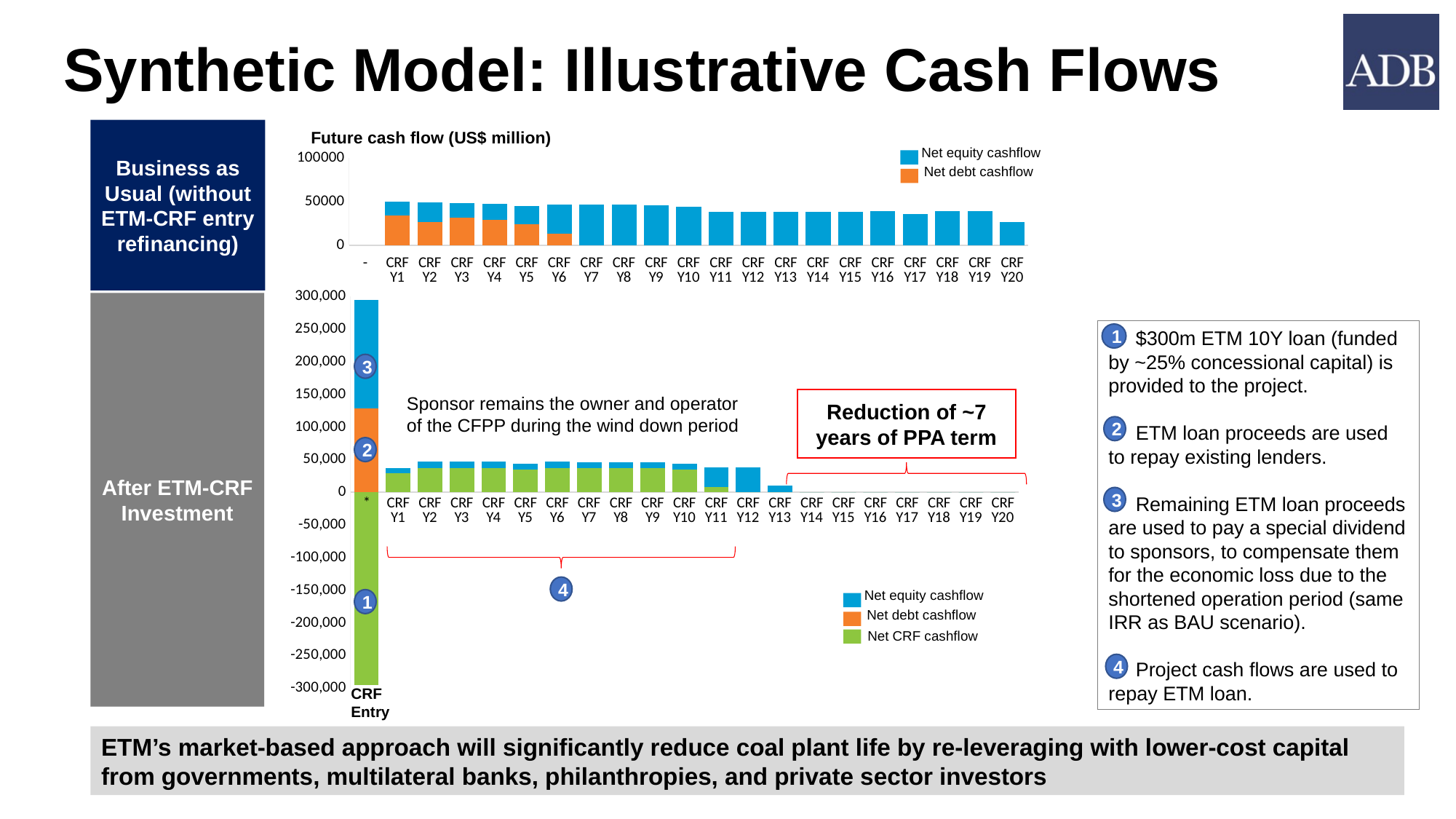
In the top 'Business as Usual' chart, is the total value for CRF Y20 greater or less than 50000? less How many series does the legend of the bottom 'After ETM-CRF Investment' chart list? 3 In the top 'Business as Usual' chart, do the bar totals generally rise or fall from CRF Y1 to CRF Y20? fall In the top 'Business as Usual' chart, what is the last CRF year that shows a Net debt cashflow segment? CRF Y6 In the bottom 'After ETM-CRF Investment' chart, what is the last CRF year with a visible bar? CRF Y13 In the bottom 'After ETM-CRF Investment' chart, which series is shown in green? Net CRF cashflow In the bottom 'After ETM-CRF Investment' chart, is the total value for CRF Y1 greater or less than 50,000? less In the bottom 'After ETM-CRF Investment' chart, is the Net CRF cashflow for CRF Entry greater or less than -250,000? less In the bottom 'After ETM-CRF Investment' chart, which category has the tallest positive bar? CRF Entry What type of chart is the top 'Business as Usual' chart? Stacked bar chart How many series does the legend of the top 'Business as Usual' chart list? 2